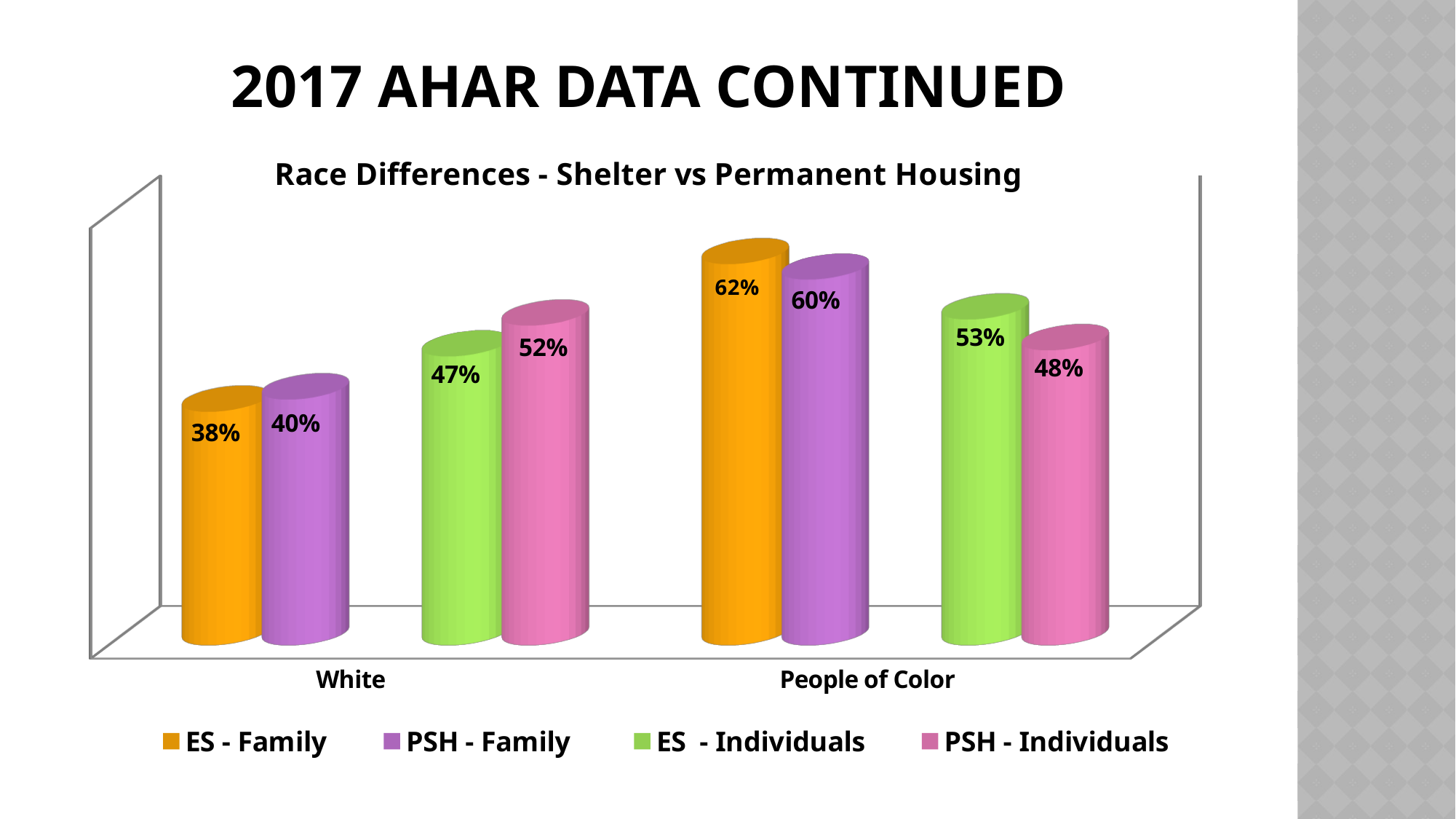
What kind of chart is shown on the slide? Bar chart What is the title of the chart? Race Differences - Shelter vs Permanent Housing How many series does the legend list? 4 What is the value for ES - Individuals in the White category? 47% Which series has the lowest value in the White category? ES - Family Which series has the highest value in the People of Color category? ES - Family What is the value for PSH - Family in the People of Color category? 60% How many categories are shown on the x axis? 2 Which is larger: PSH - Individuals for White or ES - Individuals for White? PSH - Individuals for White What is the difference between ES - Family for People of Color and ES - Family for White? 24% What is the value for PSH - Individuals in the People of Color category? 48% What is the value for ES - Family in the White category? 38%